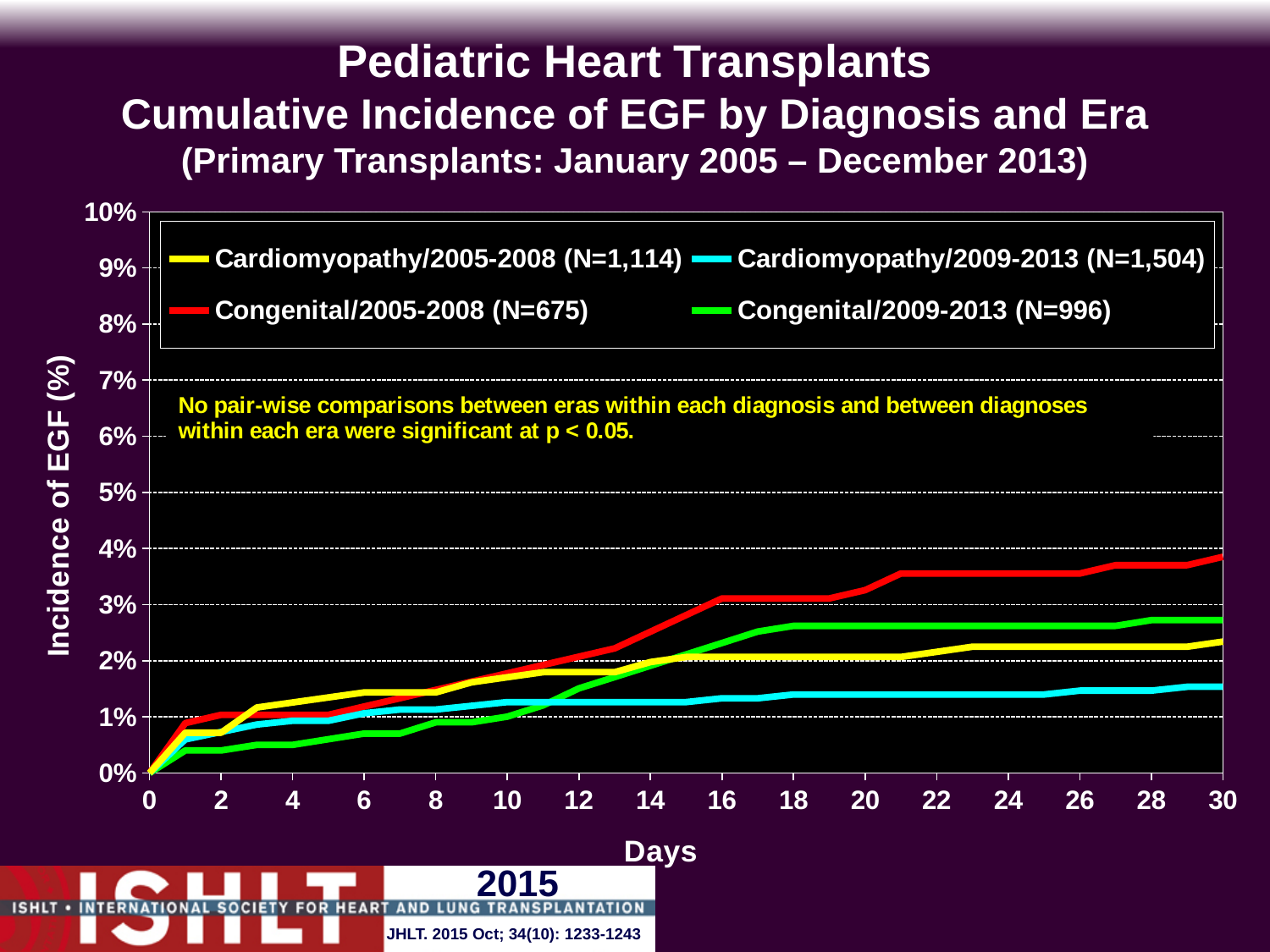
Is the value for Congenital/2009-2013 at day 30 greater or less than 3%? less Is the value for Cardiomyopathy/2005-2008 at day 30 greater or less than 2%? greater How many series does the legend list? 4 Which series has the lowest cumulative incidence of EGF at day 30? Cardiomyopathy/2009-2013 (N=1,504) What is the N shown in the legend for Congenital/2009-2013? 996 Is the value for Cardiomyopathy/2009-2013 at day 30 greater or less than 1%? greater Do the cumulative incidence values rise or fall as days increase from 0 to 30? Rise What kind of chart is shown on the slide? Line chart At day 30, which is larger: the value for Congenital/2005-2008 or Congenital/2009-2013? Congenital/2005-2008 What is the cumulative incidence of EGF for all series at day 0? 0% Which series has the highest cumulative incidence of EGF at day 30? Congenital/2005-2008 (N=675)